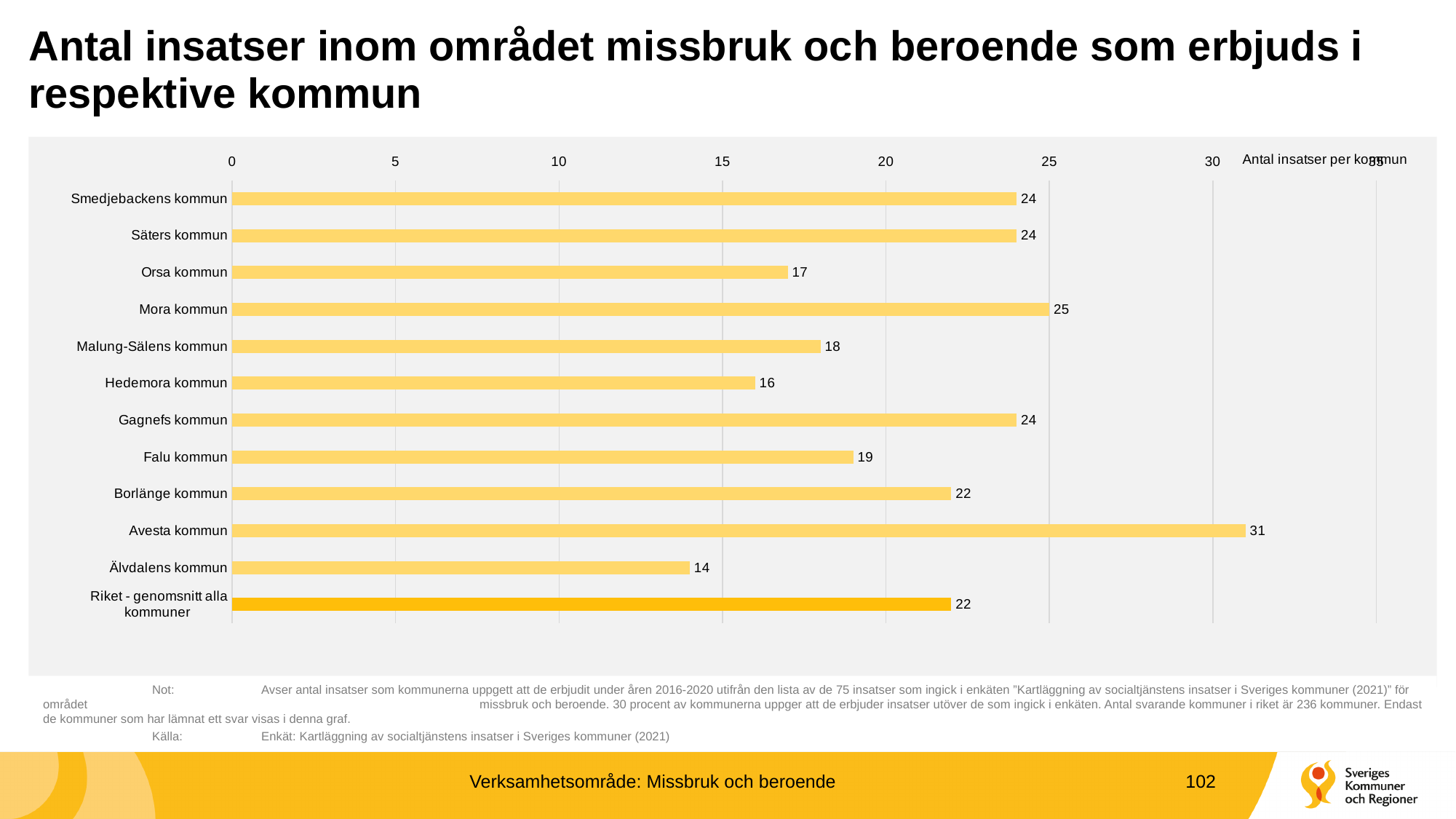
Which category has the lowest value? Älvdalens kommun What is the value for Riket - genomsnitt alla kommuner? 22 What is the value for Avesta kommun? 31 What kind of chart is shown on the slide? bar chart What is the value for Älvdalens kommun? 14 What is the difference between the values for Avesta kommun and Älvdalens kommun? 17 Is the value for Hedemora kommun greater or less than 20? less Which is larger, the value for Mora kommun or the value for Orsa kommun? Mora kommun Which category has the highest value? Avesta kommun How many categories are shown in the chart? 12 What is the label shown at the top right of the chart's axis? Antal insatser per kommun What is the difference between the values for Borlänge kommun and Falu kommun? 3